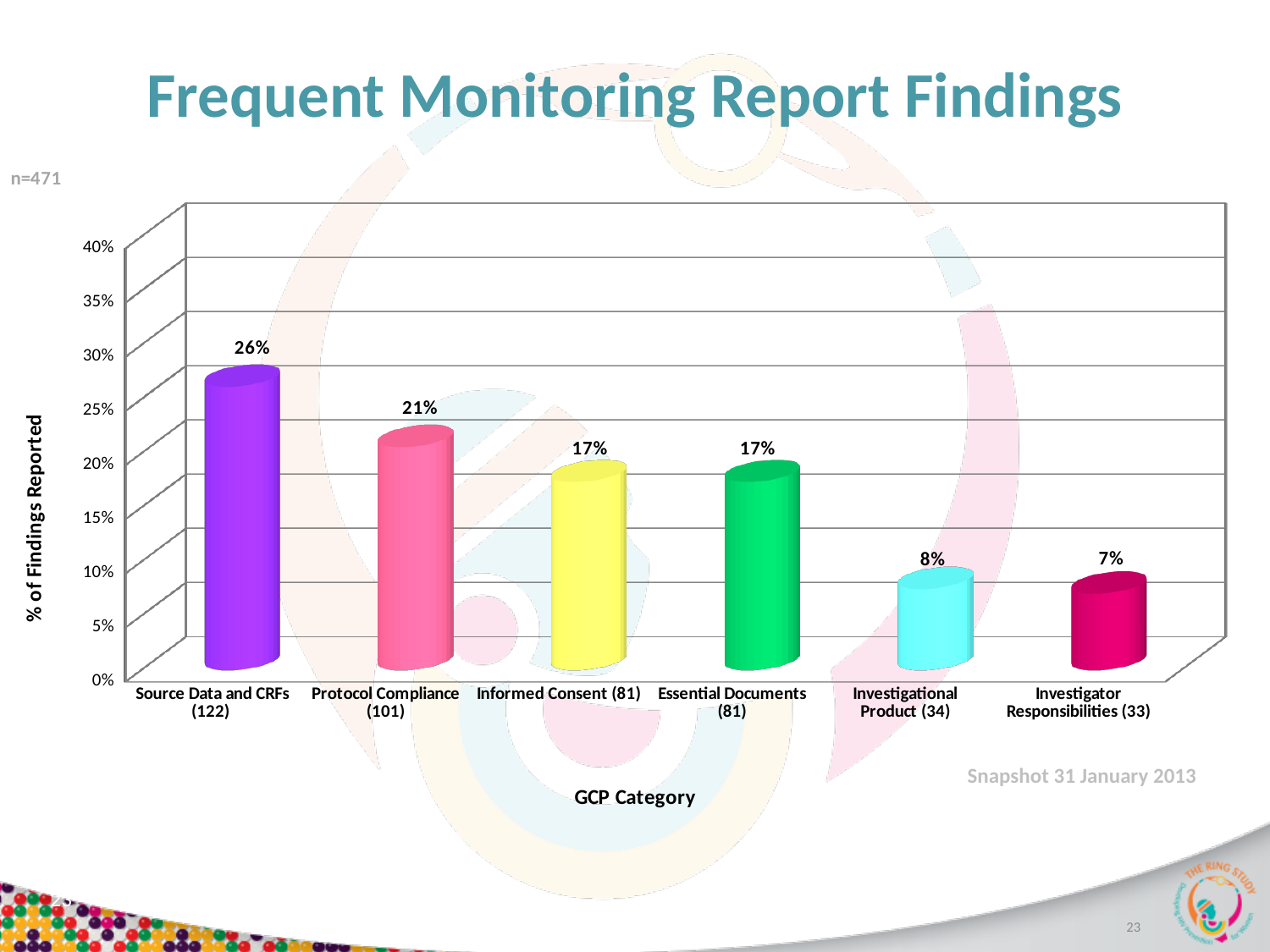
Is the value for Informed Consent (81) greater or less than 20%? less Which GCP category has the lowest percentage of findings reported? Investigator Responsibilities (33) What is the difference between the values for Source Data and CRFs (122) and Protocol Compliance (101)? 5% Which is larger, the value for Protocol Compliance (101) or the value for Essential Documents (81)? Protocol Compliance (101) What is the value for Protocol Compliance (101)? 21% What is the difference between the values for Investigational Product (34) and Investigator Responsibilities (33)? 1% What kind of chart is shown on the slide? bar chart Which GCP category has the highest percentage of findings reported? Source Data and CRFs (122) How many GCP categories are shown on the chart? 6 What is the value for Investigational Product (34)? 8% What percentage of findings reported is shown for Source Data and CRFs (122)? 26% What is the title of the chart on the slide? Frequent Monitoring Report Findings